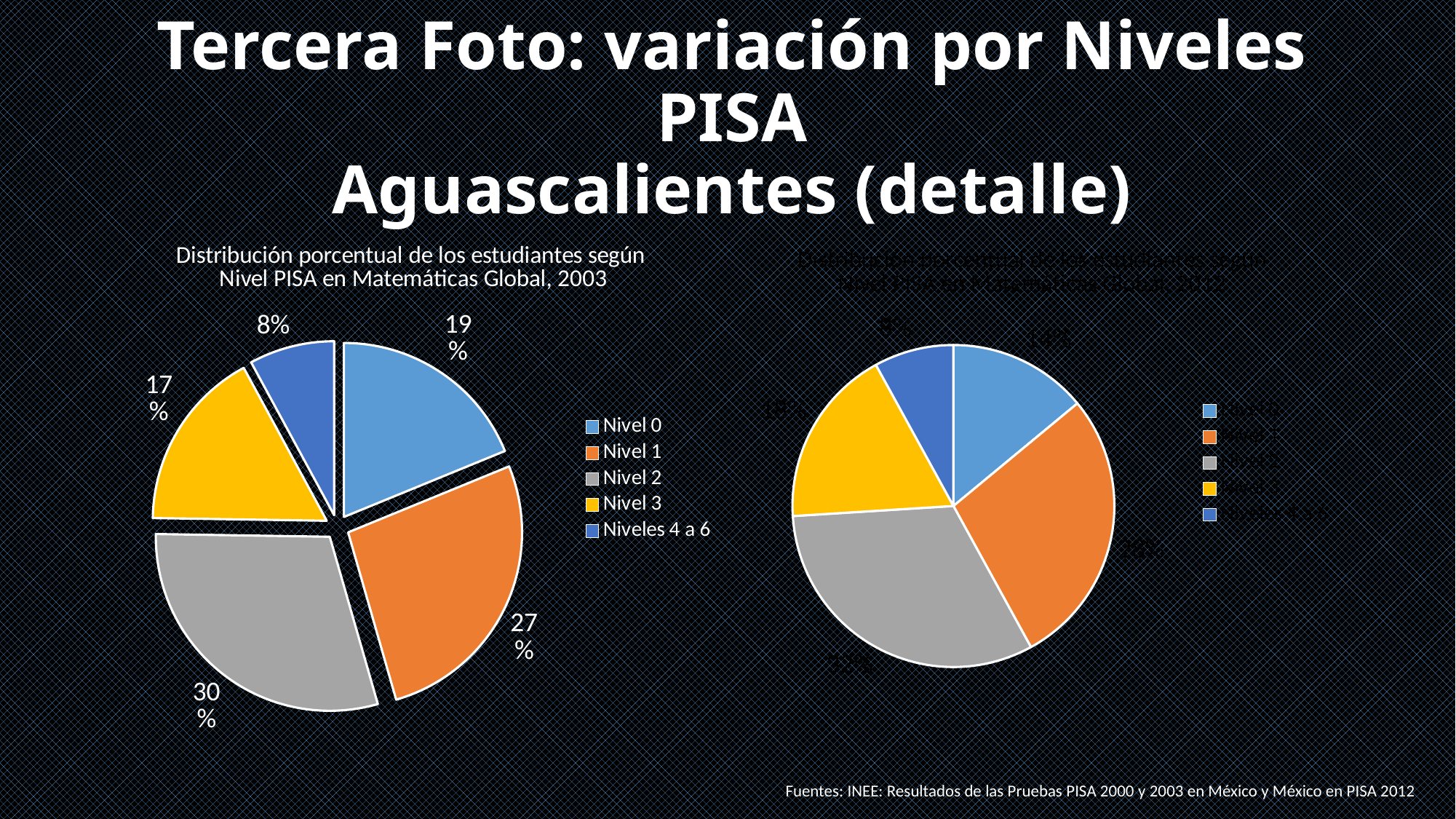
In the left chart (Matemáticas Global, 2003), what percentage of students are at Nivel 2? 30% In the left chart (Matemáticas Global, 2003), what percentage of students are at Nivel 0? 19% What type of chart is the left chart (Matemáticas Global, 2003)? Pie chart In the left chart (Matemáticas Global, 2003), what is the combined share of Nivel 0 and Nivel 1? 46% In the left chart (Matemáticas Global, 2003), what percentage of students are at Niveles 4 a 6? 8% In the left chart (Matemáticas Global, 2003), how many slices does the pie have? 5 In the left chart (Matemáticas Global, 2003), which level has the smallest share of students? Niveles 4 a 6 In the left chart (Matemáticas Global, 2003), which level has the largest share of students? Nivel 2 In the left chart (Matemáticas Global, 2003), what colour is the slice for Nivel 3? Yellow In the left chart (Matemáticas Global, 2003), what is the difference in percentage points between Nivel 1 and Nivel 3? 10 In the left chart (Matemáticas Global, 2003), what percentage of students are at Nivel 3? 17% In the left chart (Matemáticas Global, 2003), which has a larger share: Nivel 0 or Nivel 1? Nivel 1